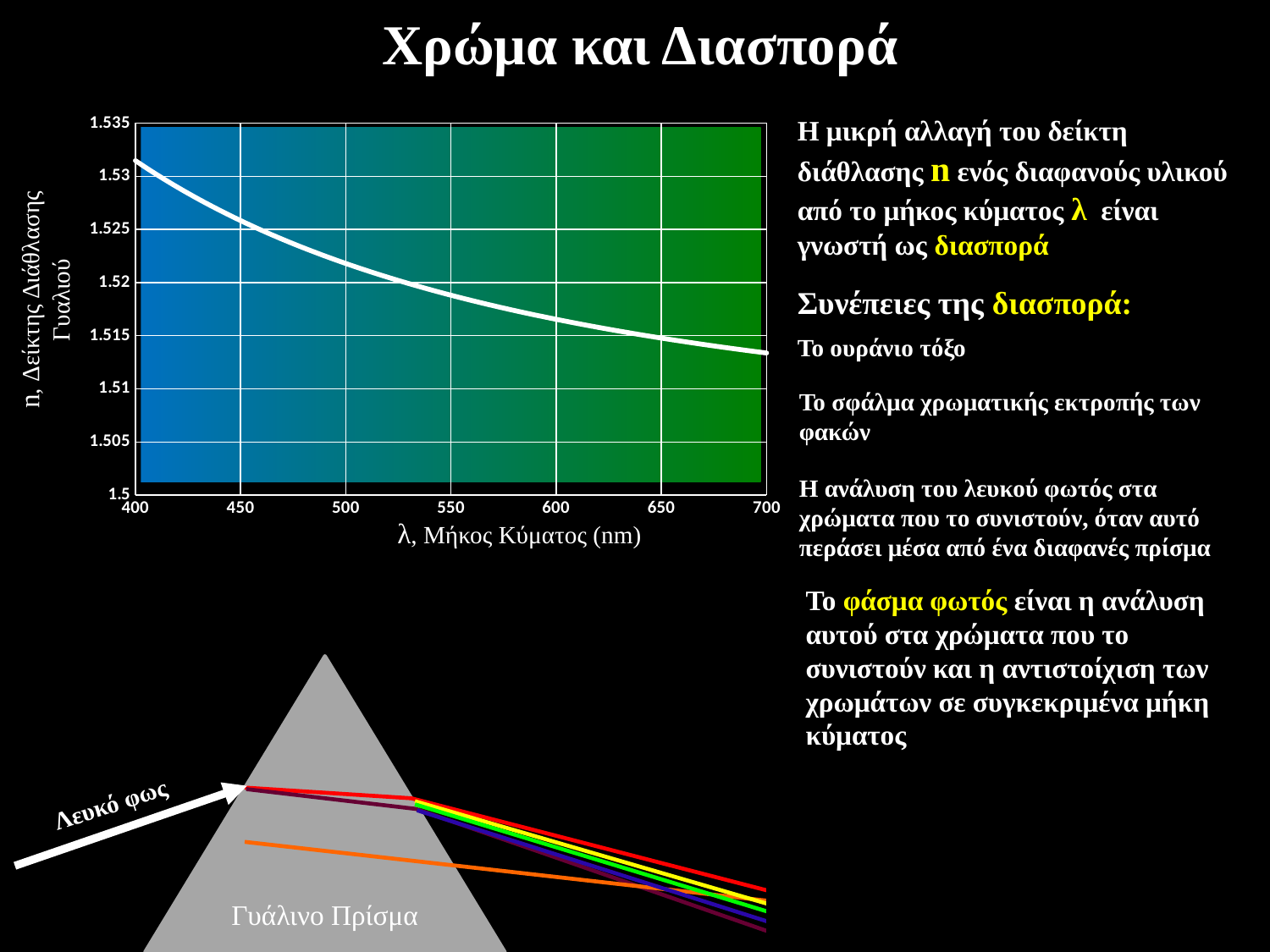
What kind of chart is shown on the slide? line chart What is the label of the y axis of the chart? n, Δείκτης Διάθλασης Γυαλιού How many series are plotted on the chart? 1 Is the refractive index at a wavelength of 450 nm greater or less than 1.525? greater What is the label of the x axis of the chart? λ, Μήκος Κύματος (nm) Does the refractive index n rise or fall as the wavelength λ increases from 400 nm to 700 nm? fall Is the refractive index at a wavelength of 400 nm greater or less than 1.53? greater Is the refractive index at a wavelength of 500 nm greater or less than 1.52? greater Which wavelength has the higher refractive index, 400 nm or 700 nm? 400 nm Which wavelength has the lower refractive index, 500 nm or 650 nm? 650 nm